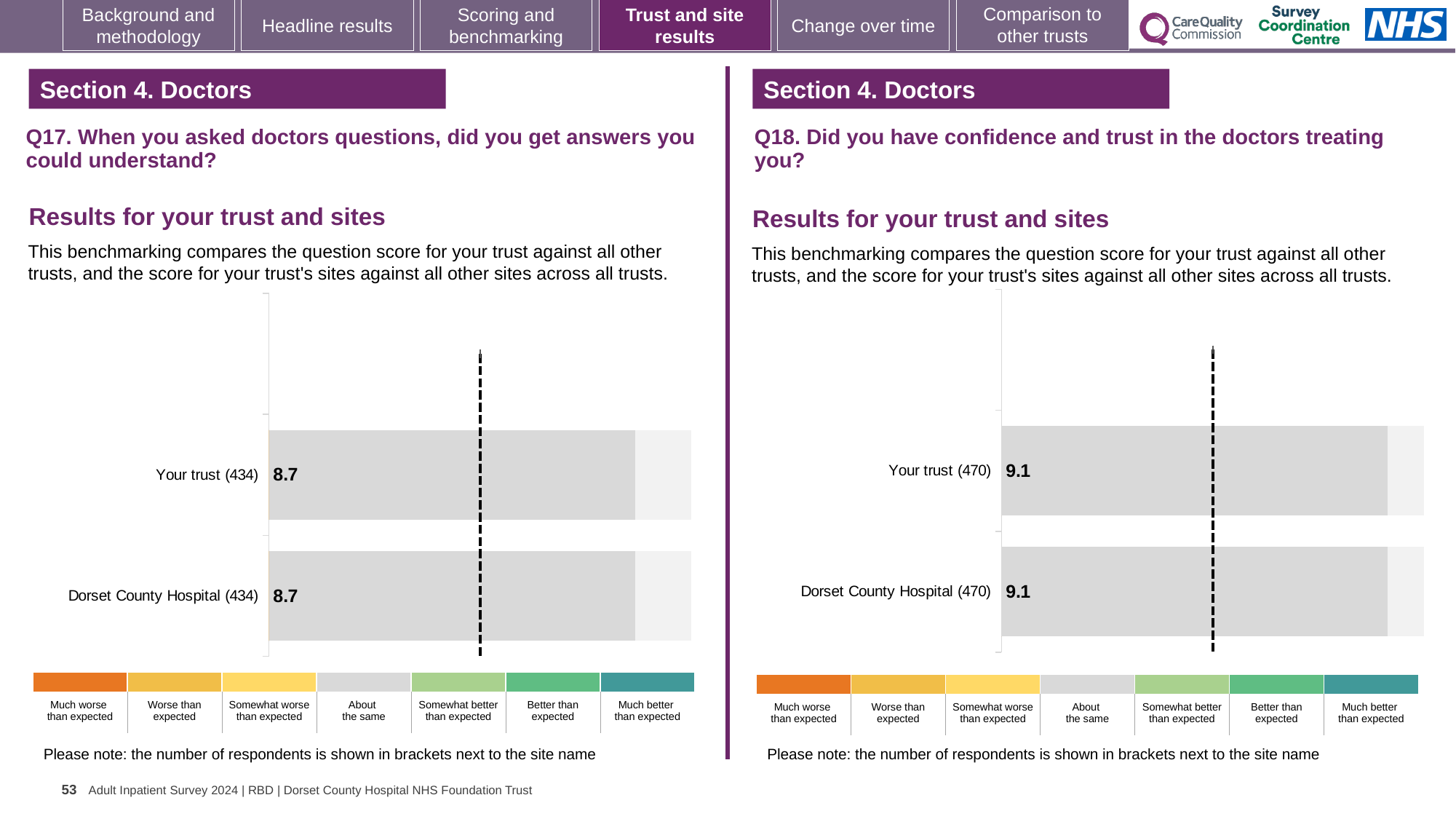
On the Q17 chart (left), what is the score for Dorset County Hospital? 8.7 On the Q18 chart (right), how many respondents are shown in brackets for Dorset County Hospital? 470 On the Q17 chart (left), what is the score for Your trust? 8.7 On the Q17 chart (left), how many respondents are shown in brackets for Your trust? 434 How many bars are plotted on the Q18 chart (right)? 2 On the Q18 chart (right), what is the difference between the Your trust score and the Dorset County Hospital score? 0 Is the Your trust score on the Q18 chart (right) larger or smaller than the Your trust score on the Q17 chart (left)? Larger How many bars are plotted on the Q17 chart (left)? 2 On the Q17 chart (left), what is the difference between the Your trust score and the Dorset County Hospital score? 0 On the Q18 chart (right), what is the score for Your trust? 9.1 What type of chart is used on the Q17 chart (left)? Bar chart On the Q18 chart (right), what is the score for Dorset County Hospital? 9.1